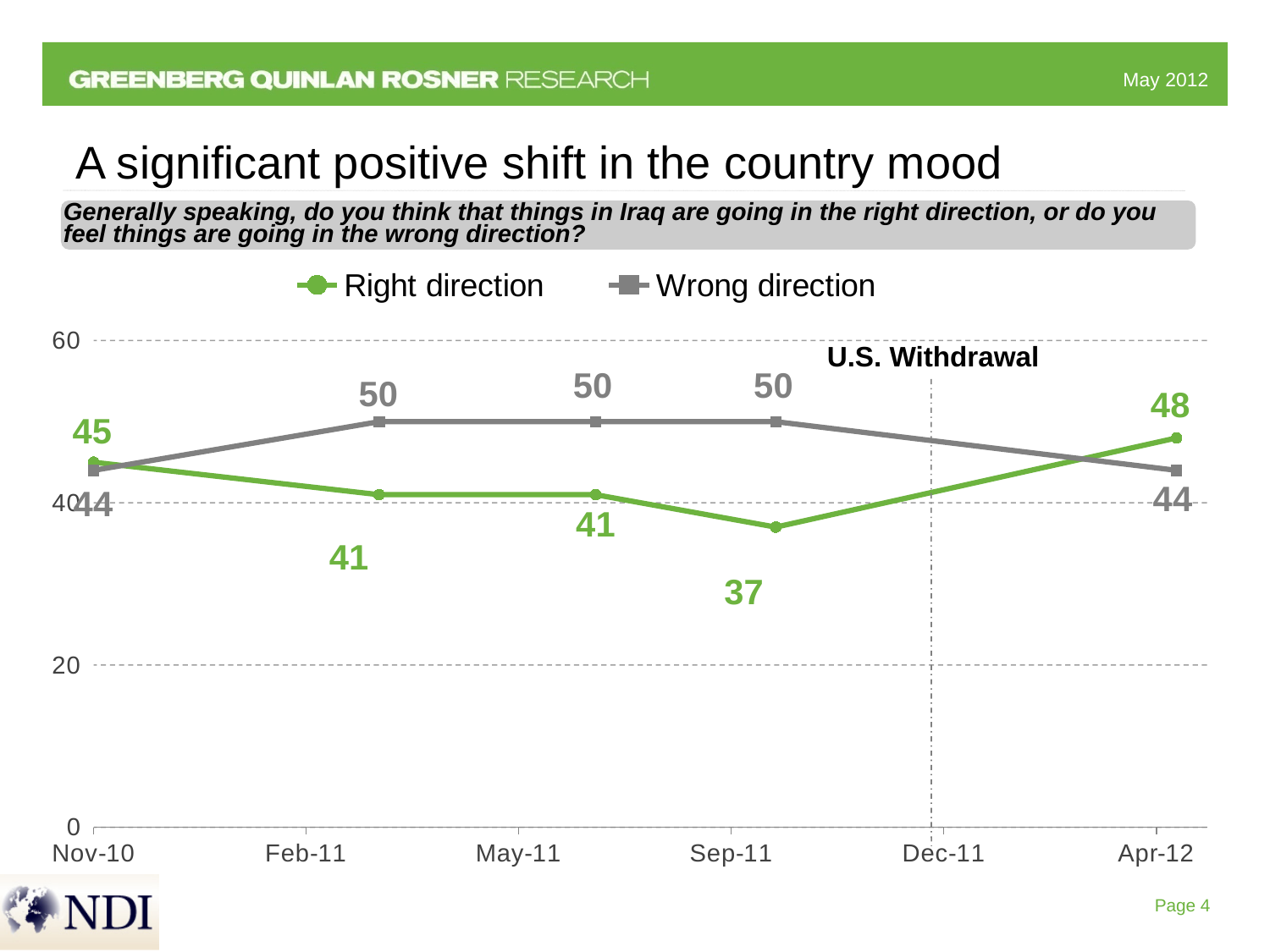
What label is attached to the vertical dashed line near Dec-11? U.S. Withdrawal What is the Right direction value at Nov-10? 45 At Apr-12, what is the difference between the Right direction and Wrong direction values? 4 What is the Wrong direction value at Nov-10? 44 What is the Wrong direction value at Apr-12? 44 What is the lowest value plotted for the Right direction series? 37 At Apr-12, which series has the larger value, Right direction or Wrong direction? Right direction What is the Right direction value at Apr-12? 48 What is the highest value plotted for the Wrong direction series? 50 What kind of chart is shown on the slide? Line chart How many series does the legend list? 2 How many data points are plotted for each series? 5